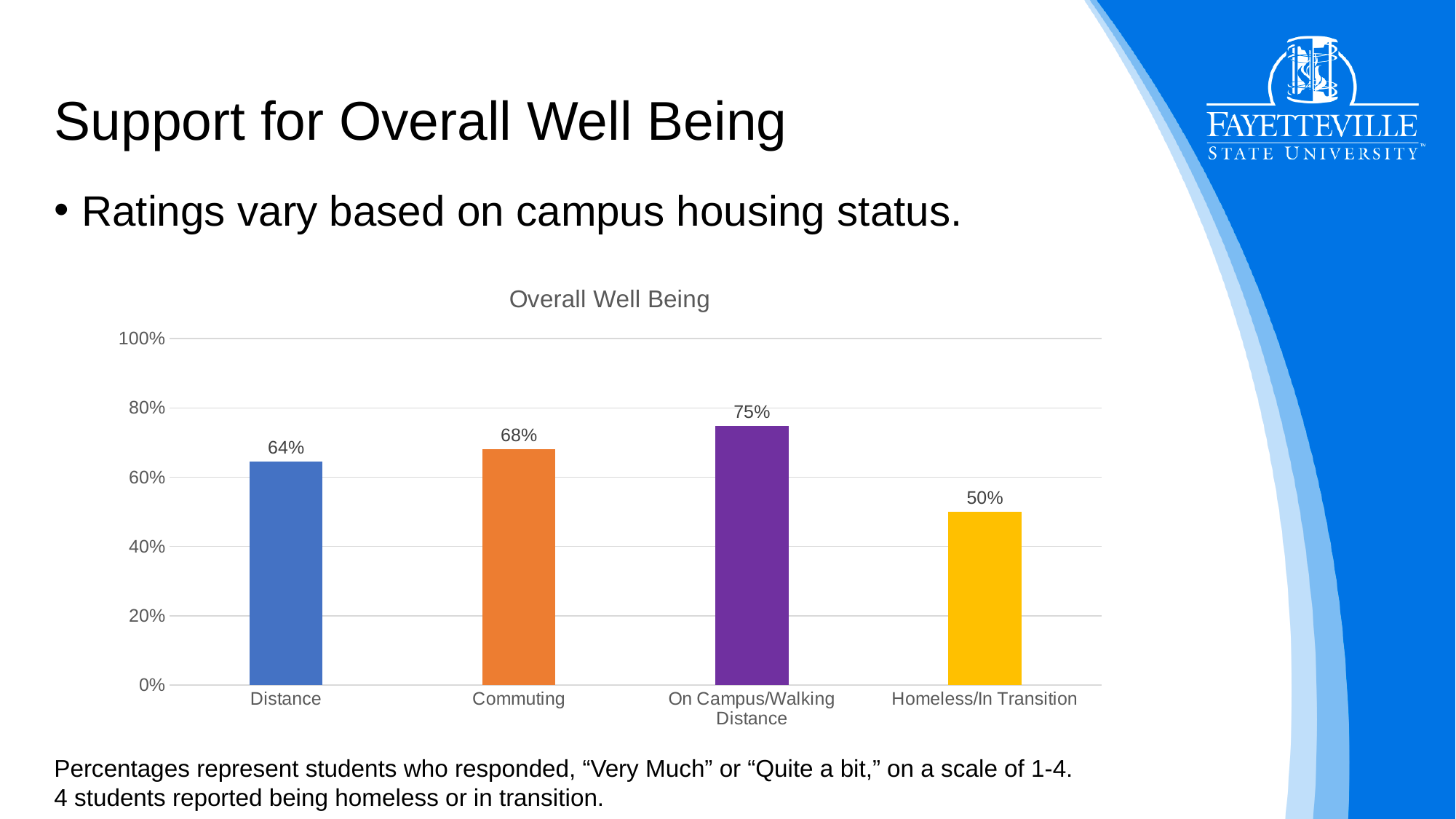
Which category has the lowest value? Homeless/In Transition How many categories are shown on the x axis? 4 What is the difference between the values for Commuting and Distance? 4% What is the value for Commuting? 68% What kind of chart is shown on the slide? Bar chart What is the value for Distance? 64% Which category has the highest value? On Campus/Walking Distance What is the value for Homeless/In Transition? 50% Which is larger, the value for Commuting or the value for Distance? Commuting What is the value for On Campus/Walking Distance? 75% What is the title of the chart? Overall Well Being What is the difference between the values for On Campus/Walking Distance and Homeless/In Transition? 25%